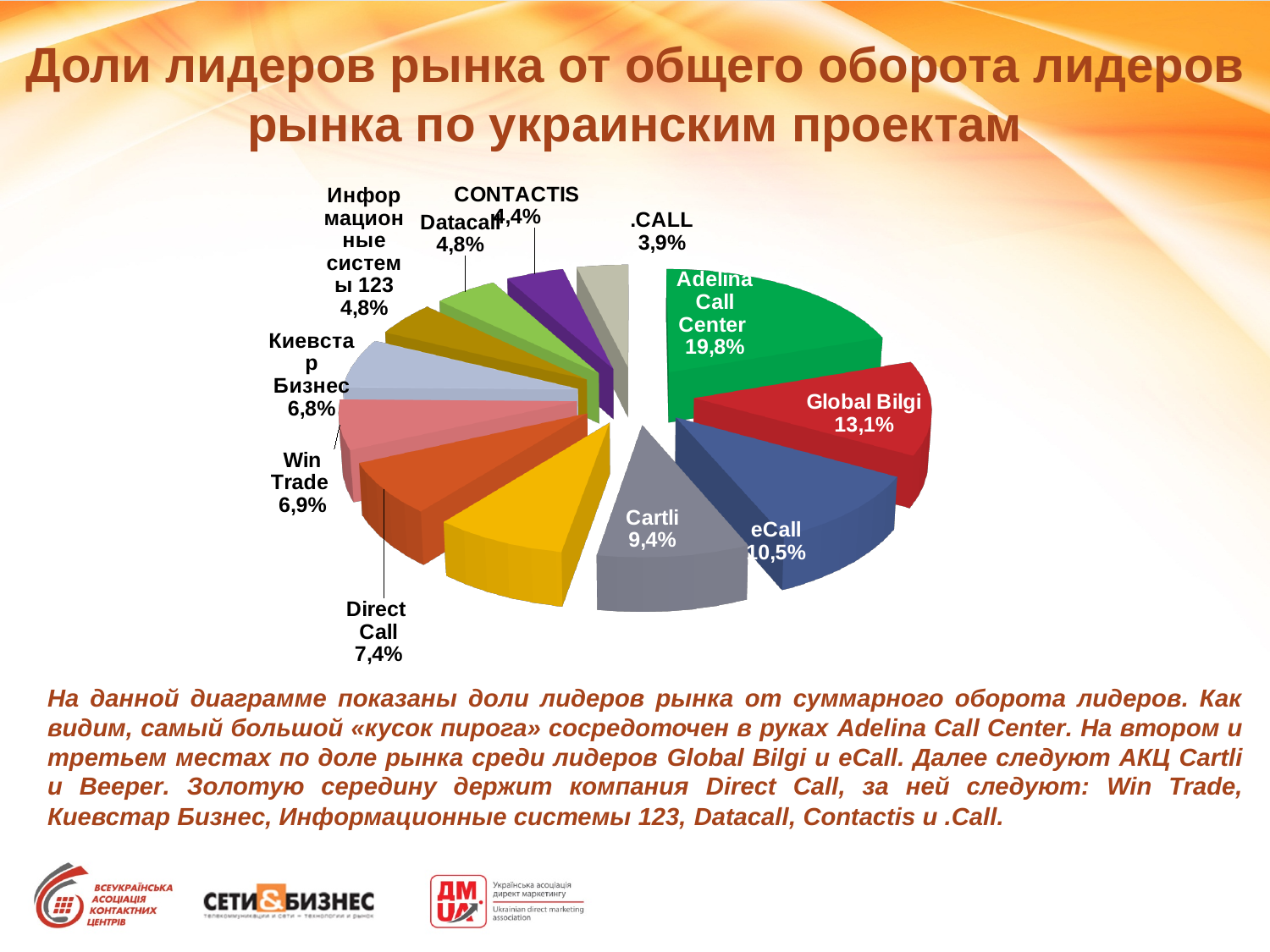
What share does Direct Call hold in the pie chart? 7,4% What share does Global Bilgi hold in the pie chart? 13,1% How many slices does the pie chart have? 12 What share does Adelina Call Center hold in the pie chart? 19,8% Which company has the smallest slice of the pie chart? .CALL Which has a larger share, Cartli or Win Trade? Cartli What is the difference between the shares of Adelina Call Center and Global Bilgi? 6,7% What share does CONTACTIS hold in the pie chart? 4,4% Which company has the largest slice of the pie chart? Adelina Call Center What kind of chart is shown on the slide? pie chart What is the title of the slide? Доли лидеров рынка от общего оборота лидеров рынка по украинским проектам What share does eCall hold in the pie chart? 10,5%